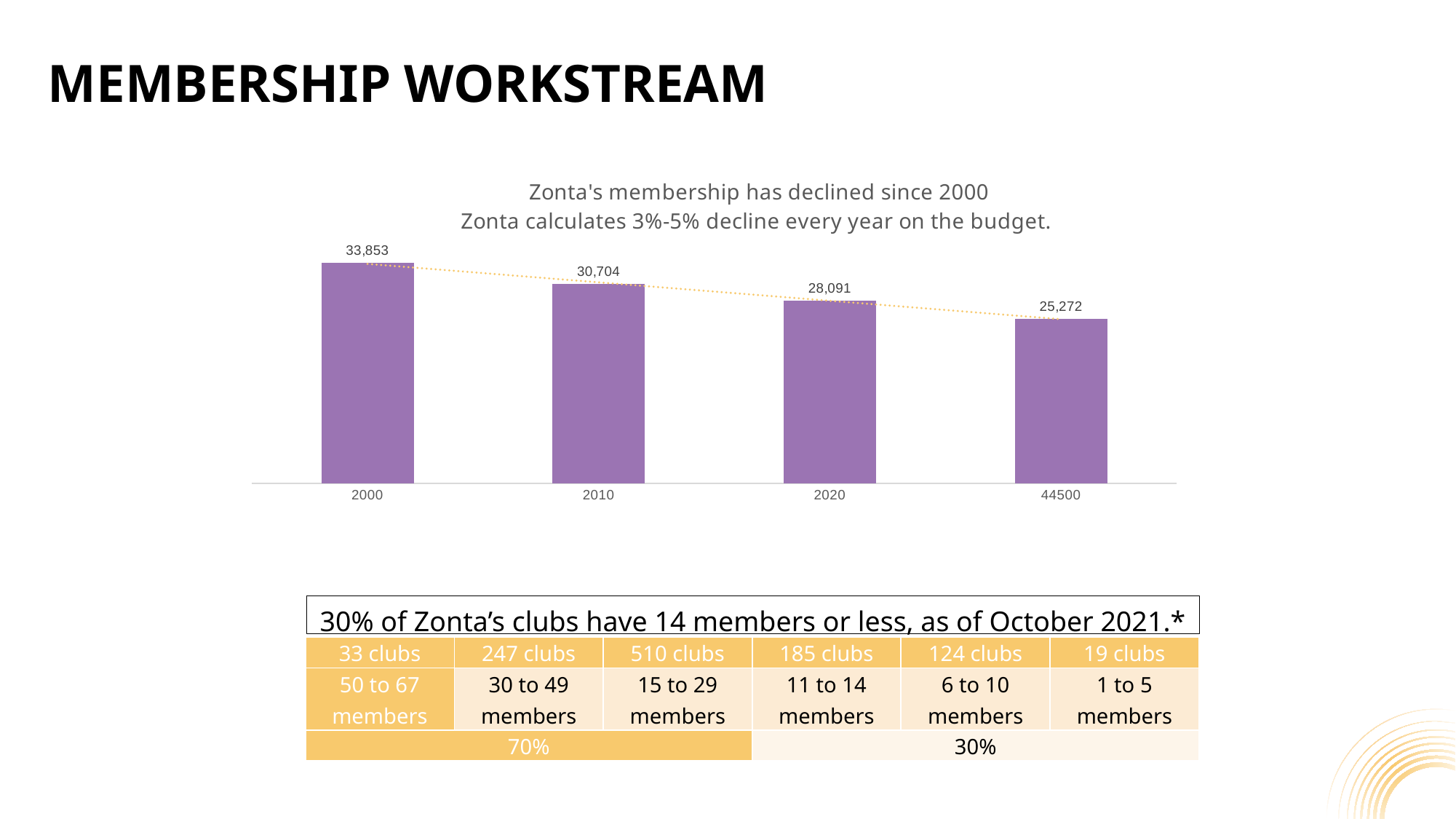
What is the membership value shown for the category labelled 44500? 25,272 What is the difference between the membership values for 2020 and the category labelled 44500? 2,819 Which is larger, the membership value for 2010 or for 2020? 2010 What kind of chart is shown on the slide? Bar chart Which category has the highest membership value? 2000 What is the membership value shown for 2020? 28,091 How many bars are plotted in the chart? 4 Which category has the lowest membership value? 44500 What is the membership value shown for 2010? 30,704 What is the membership value shown for 2000? 33,853 What is the difference between the membership values for 2000 and 2010? 3,149 Do the membership values rise or fall from left to right along the x axis? Fall